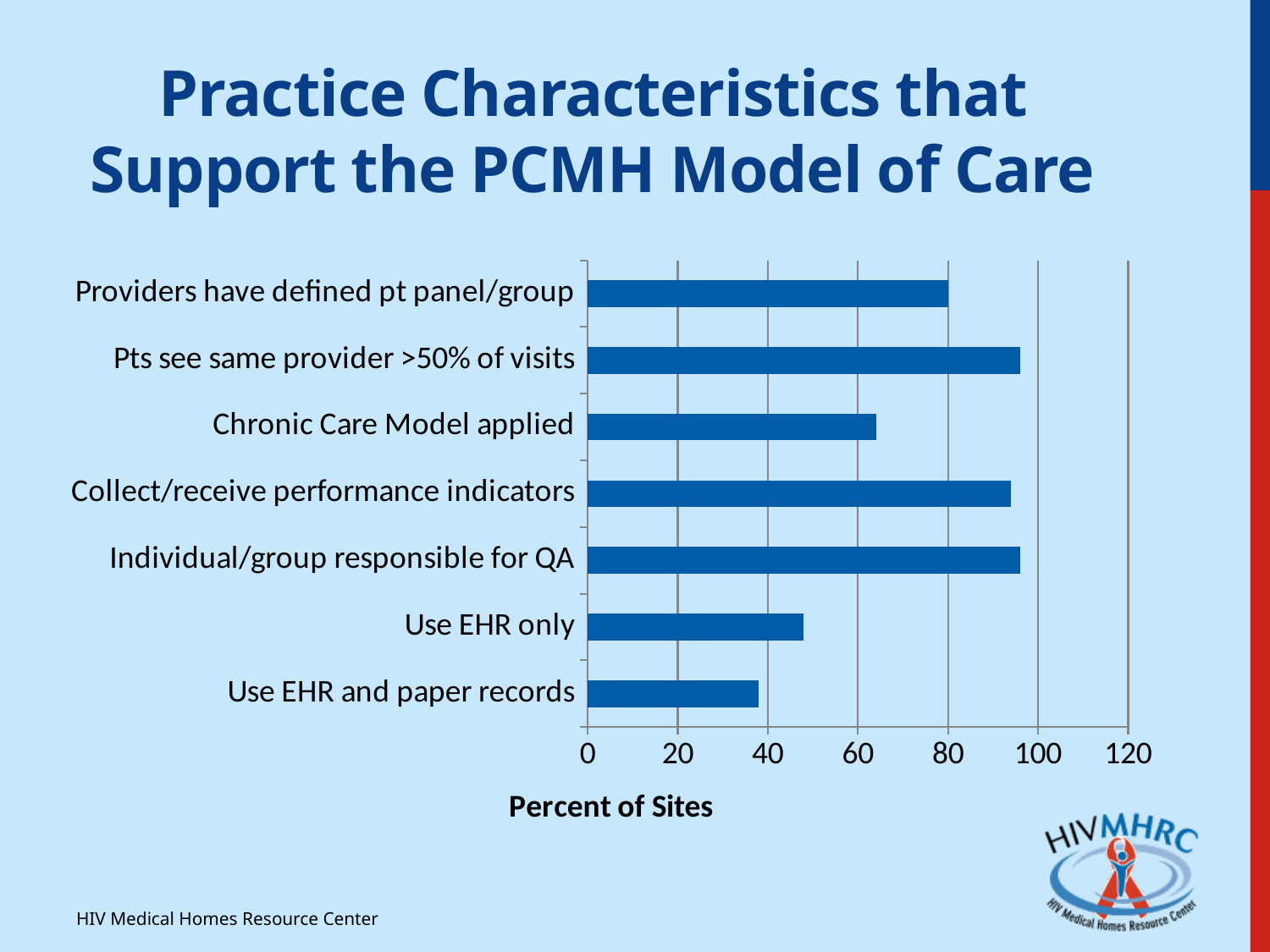
Is the value for 'Use EHR only' greater or less than 40? greater Which has a higher percent of sites: 'Chronic Care Model applied' or 'Use EHR only'? Chronic Care Model applied Which practice characteristic has the lowest percent of sites? Use EHR and paper records Is the value for 'Use EHR and paper records' greater or less than 40? less What kind of chart is shown on the slide? bar chart What is the label of the horizontal axis of the chart? Percent of Sites Which has a higher percent of sites: 'Collect/receive performance indicators' or 'Providers have defined pt panel/group'? Collect/receive performance indicators Is the value for 'Chronic Care Model applied' greater or less than 60? greater What is the highest value shown on the horizontal axis of the chart? 120 How many practice characteristics (categories) are plotted in the chart? 7